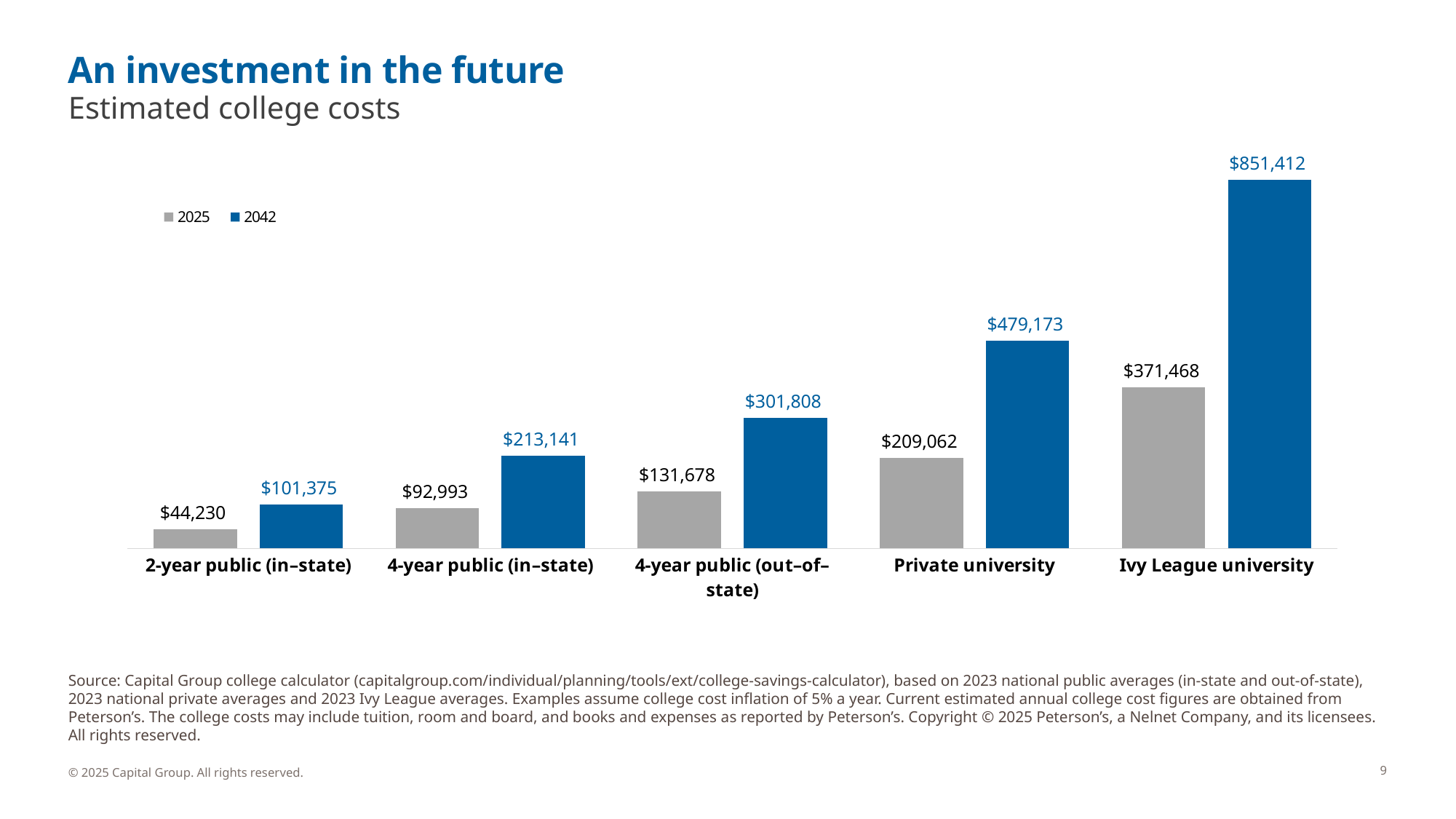
Which colour represents the 2042 series in the chart? Blue What kind of chart is shown on the slide? Bar chart What is the difference between the 2042 cost of a 4-year public (out-of-state) college and a 4-year public (in-state) college? $88,667 How many series does the legend list? 2 What is the 2025 cost for a 4-year public (in-state) college? $92,993 How many college categories are shown on the x axis? 5 Which is larger: the 2025 cost of an Ivy League university or the 2042 cost of a 4-year public (out-of-state) college? 2025 cost of an Ivy League university What is the difference between the 2042 and 2025 costs for an Ivy League university? $479,944 What is the estimated 2042 cost for a Private university? $479,173 Which category has the lowest 2025 cost? 2-year public (in-state) What is the 2042 cost for a 2-year public (in-state) college? $101,375 Which category has the highest 2042 cost? Ivy League university